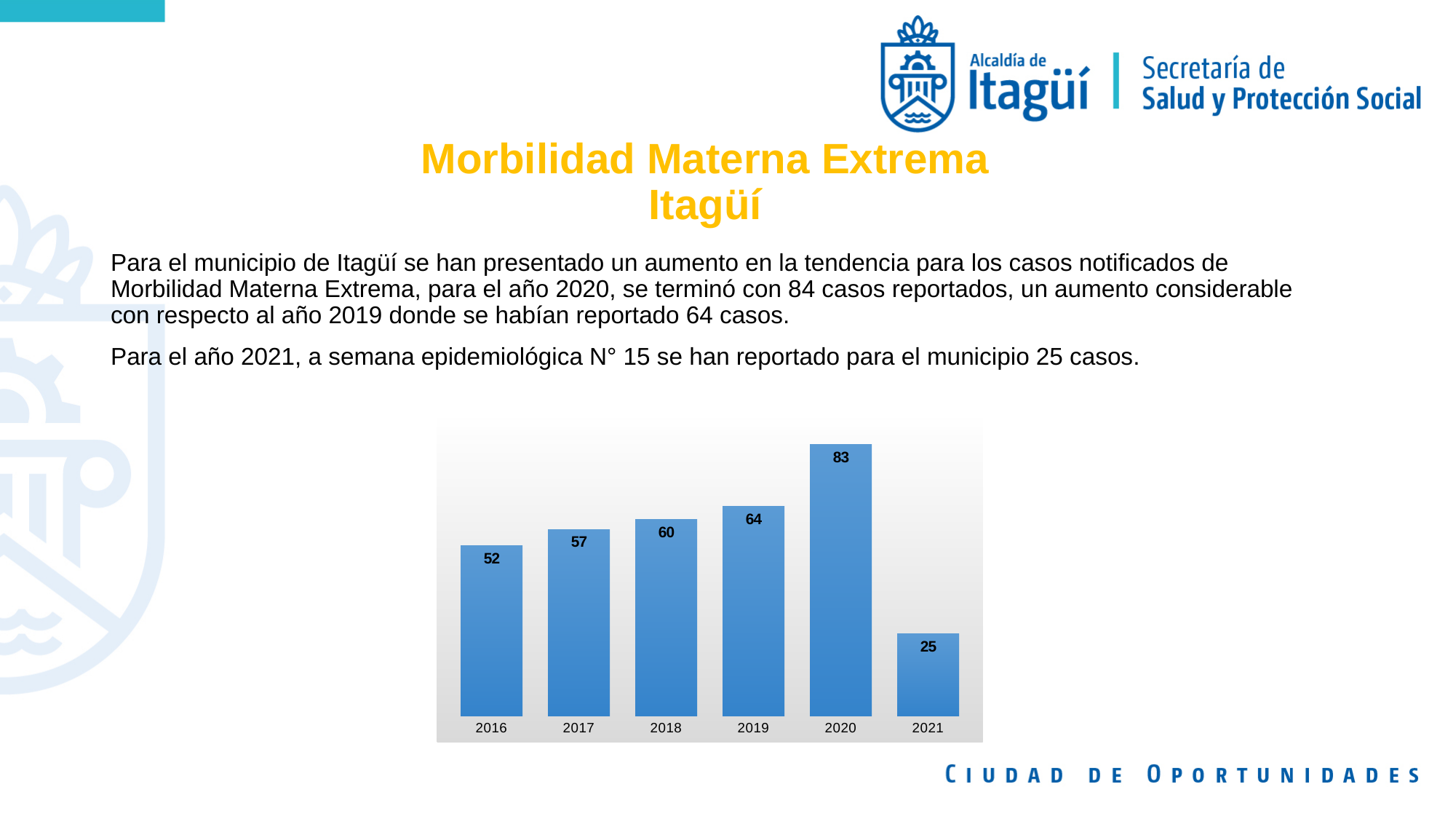
What is the difference between the values for 2018 and 2016? 8 What is the difference between the values for 2020 and 2019? 19 What is the value shown for 2019? 64 Do the values rise or fall from 2016 to 2020? rise What colour are the bars in the chart? blue Which year has the lowest value in the chart? 2021 What kind of chart is shown on the slide? bar chart What is the value shown for 2021? 25 How many years are shown on the x axis of the chart? 6 Which year has the highest value in the chart? 2020 What is the value shown for 2016? 52 Which is larger, the value for 2017 or the value for 2018? 2018